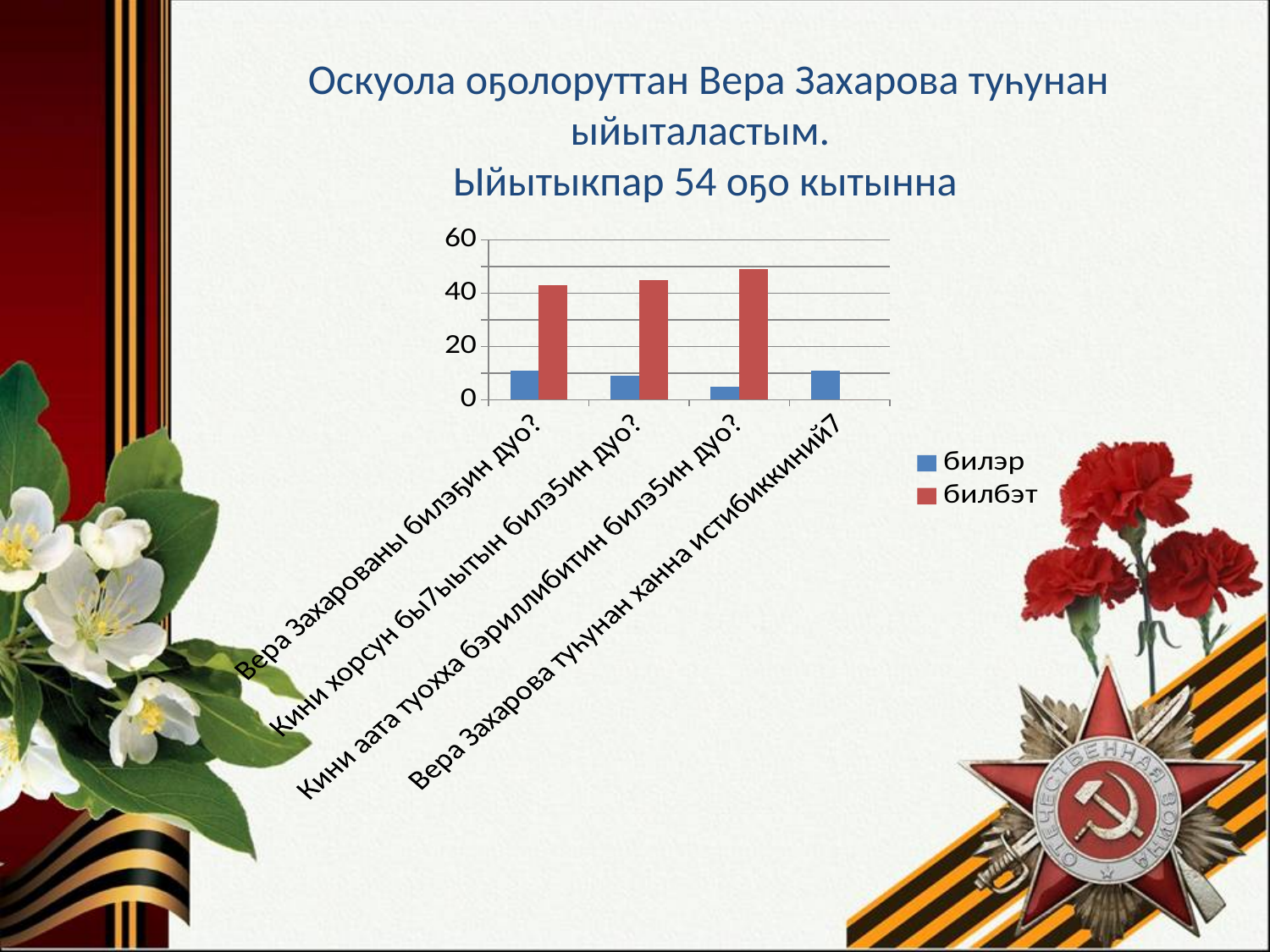
For which category is the 'билэр' bar the lowest? Кини аата туохха бэриллибитин билэ5ин дуо? Is the 'билэр' value for 'Кини аата туохха бэриллибитин билэ5ин дуо?' greater or less than 20? less What are the two series named in the chart legend? билэр and билбэт What kind of chart is shown on the slide? bar chart Is the 'билэр' value for 'Вера Захарованы билэ5ин дуо?' greater or less than 20? less How many series does the chart legend list? 2 How many categories are shown on the x axis of the chart? 4 For 'Вера Захарованы билэ5ин дуо?', which series has the larger value, 'билэр' or 'билбэт'? билбэт For which category is the 'билбэт' bar the highest? Кини аата туохха бэриллибитин билэ5ин дуо? Which category has no 'билбэт' bar shown? Вера Захарова туһунан ханна истибиккиний7 Which colour represents the series 'билбэт' in the chart? red Is the 'билбэт' value for 'Кини аата туохха бэриллибитин билэ5ин дуо?' greater or less than 40? greater